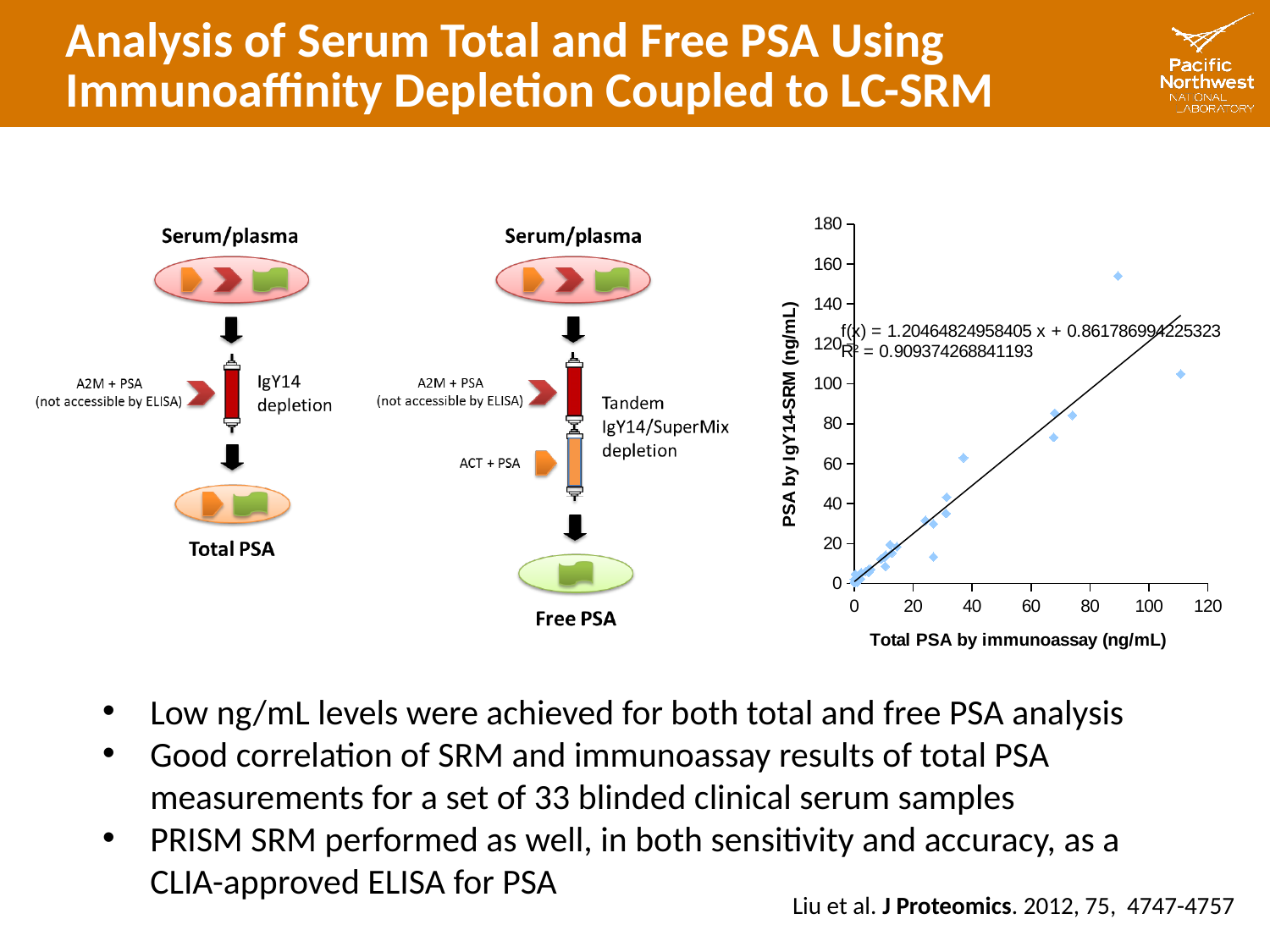
What is the title of the x axis of the scatter chart? Total PSA by immunoassay (ng/mL) What is the maximum value shown on the y axis of the scatter chart? 180 What is the title of the y axis of the scatter chart? PSA by IgY14-SRM (ng/mL) What is the R² value shown for the trendline on the scatter chart? 0.909374268841193 Is the highest plotted point on the scatter chart greater or less than 140 ng/mL on the y axis? greater What kind of chart is shown on the slide? scatter chart What is the intercept of the trendline equation f(x) shown on the scatter chart? 0.861786994225323 What is the slope of the trendline equation f(x) shown on the scatter chart? 1.20464824958405 Is the point with the largest x value (around 110 ng/mL by immunoassay) greater or less than 120 ng/mL on the y axis? less What is the maximum value shown on the x axis of the scatter chart? 120 Do the plotted points on the scatter chart generally rise or fall as Total PSA by immunoassay increases? rise